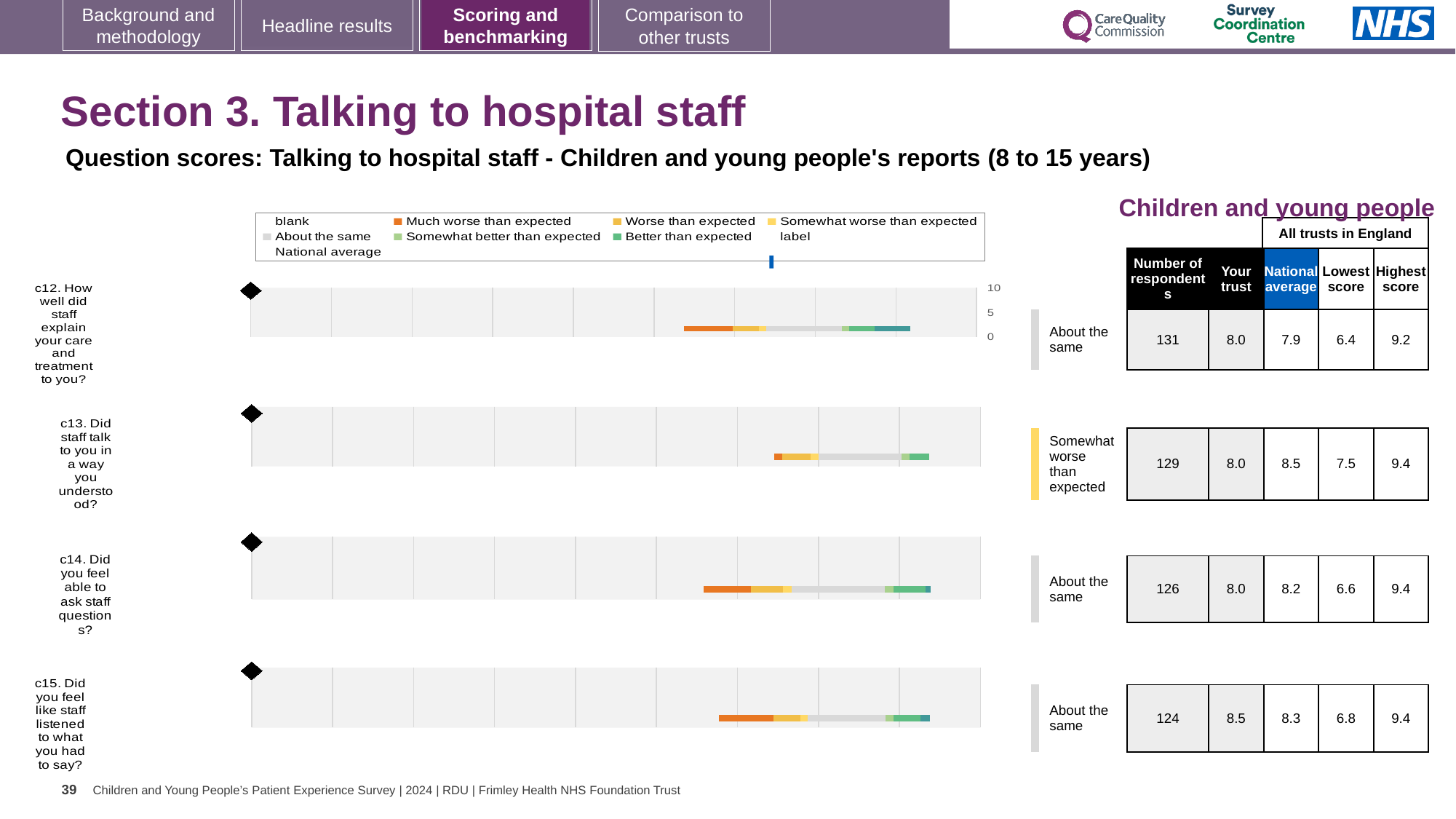
Which question has the most respondents? c12 What is the difference between the national average and the trust score for c13? 0.5 How many survey questions (c12 to c15) have a benchmarking chart on this slide? 4 What is the lowest score across all trusts in England for c12? 6.4 What is the number of respondents for c15 (Did you feel like staff listened to what you had to say?)? 124 For c15, is the trust score higher or lower than the national average? higher What kind of chart is used for each question's benchmarking display? bar chart What benchmark category is shown for c13? Somewhat worse than expected What is the national average for c13 (Did staff talk to you in a way you understood?)? 8.5 Which question has the highest 'Your trust' score? c15 What is the highest score across all trusts in England for c14 (Did you feel able to ask staff questions?)? 9.4 What is the 'Your trust' score for c12 (How well did staff explain your care and treatment to you?)? 8.0